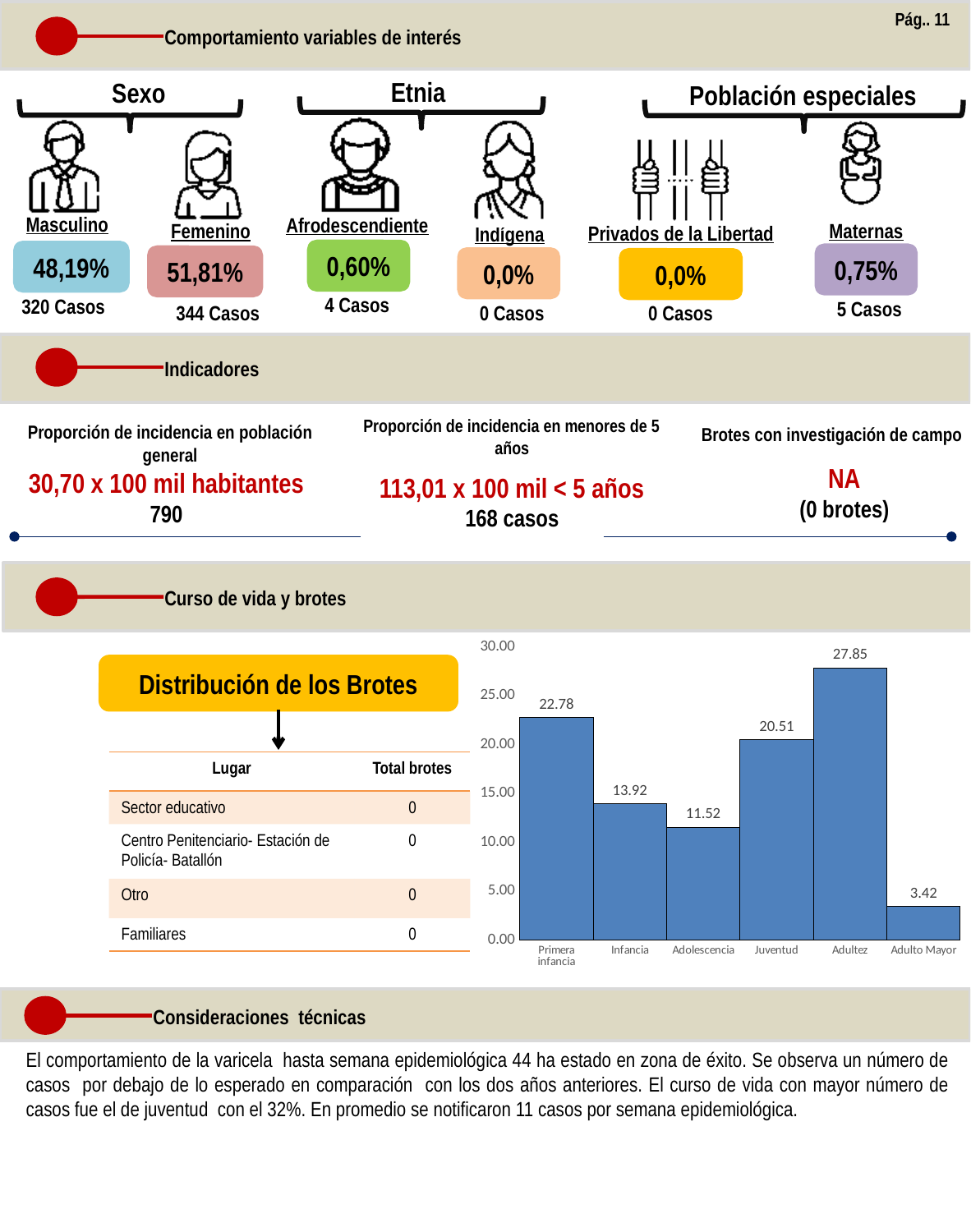
How many categories are shown on the x axis of the bar chart? 6 In the bar chart, what is the difference between the values for Primera infancia and Infancia? 8.86 In the bar chart, which is larger: the value for Infancia or the value for Adolescencia? Infancia In the bar chart, is the value for Juventud greater or less than 20.00? greater In the bar chart, what is the value for Adulto Mayor? 3.42 In the bar chart, what is the value for Adultez? 27.85 Which category has the highest value in the bar chart? Adultez Which category has the lowest value in the bar chart? Adulto Mayor In the bar chart, what is the difference between the values for Adultez and Juventud? 7.34 In the bar chart, what is the value for Adolescencia? 11.52 In the bar chart, what is the value for Primera infancia? 22.78 What type of chart is shown in the 'Curso de vida y brotes' section? bar chart